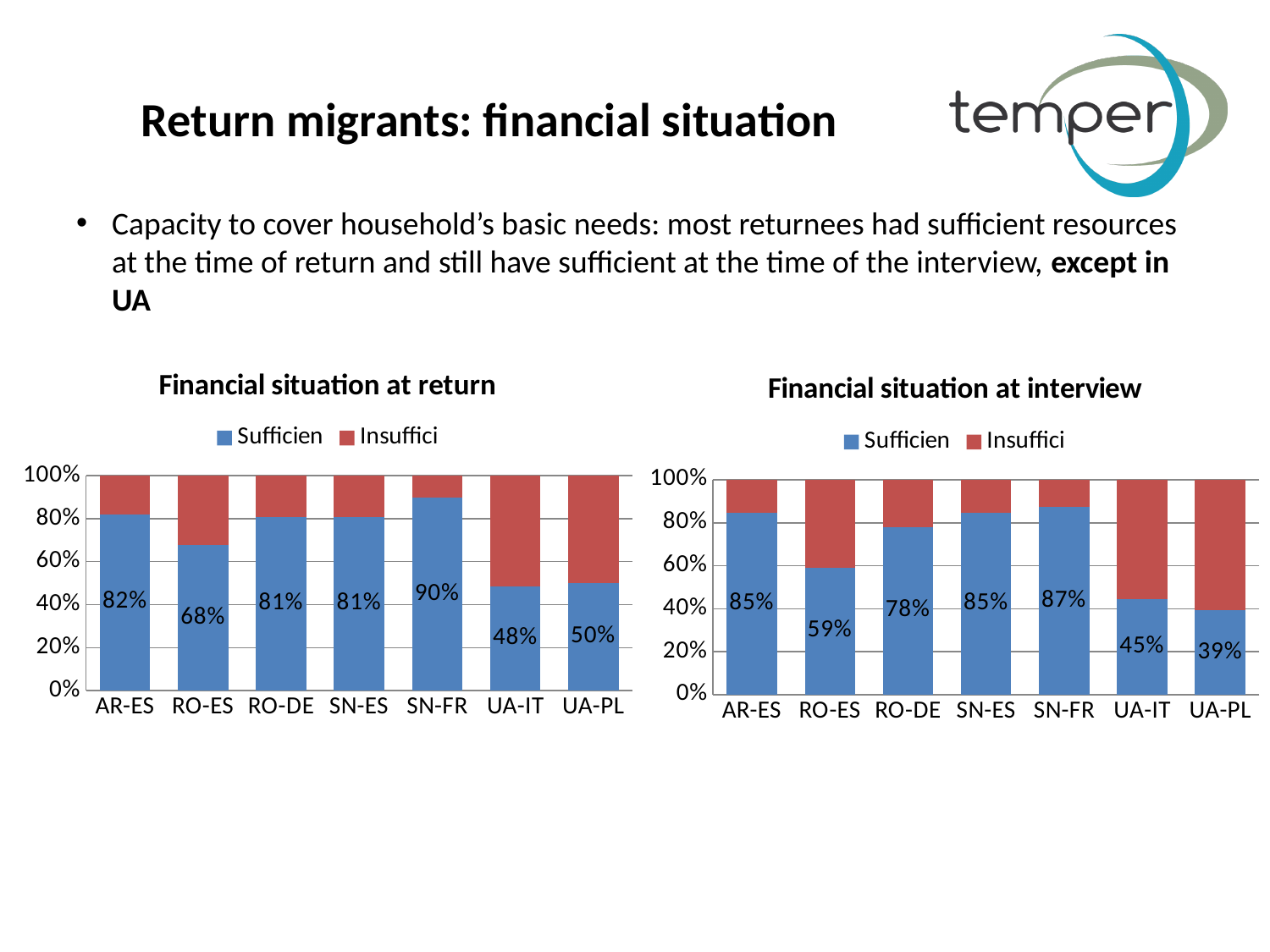
In the 'Financial situation at return' chart, what is the difference between the Sufficien values for AR-ES and RO-ES? 14 percentage points How many series does the legend of the 'Financial situation at interview' chart list? 2 In the 'Financial situation at return' chart, which colour represents the Sufficien series? Blue In the 'Financial situation at interview' chart, which category has the highest Sufficien value? SN-FR What kind of chart is 'Financial situation at interview'? Stacked bar chart In the 'Financial situation at return' chart, is the Insuffici share for UA-IT greater or less than 40%? greater How many categories are shown on the x axis of the 'Financial situation at return' chart? 7 In the 'Financial situation at return' chart, what is the Sufficien value for SN-FR? 90% In the 'Financial situation at interview' chart, which has a larger Sufficien value, RO-ES or RO-DE? RO-DE In the 'Financial situation at interview' chart, what is the difference between the Sufficien values for SN-FR and UA-IT? 42 percentage points In the 'Financial situation at return' chart, which category has the lowest Sufficien value? UA-IT In the 'Financial situation at interview' chart, what is the Sufficien value for UA-PL? 39%